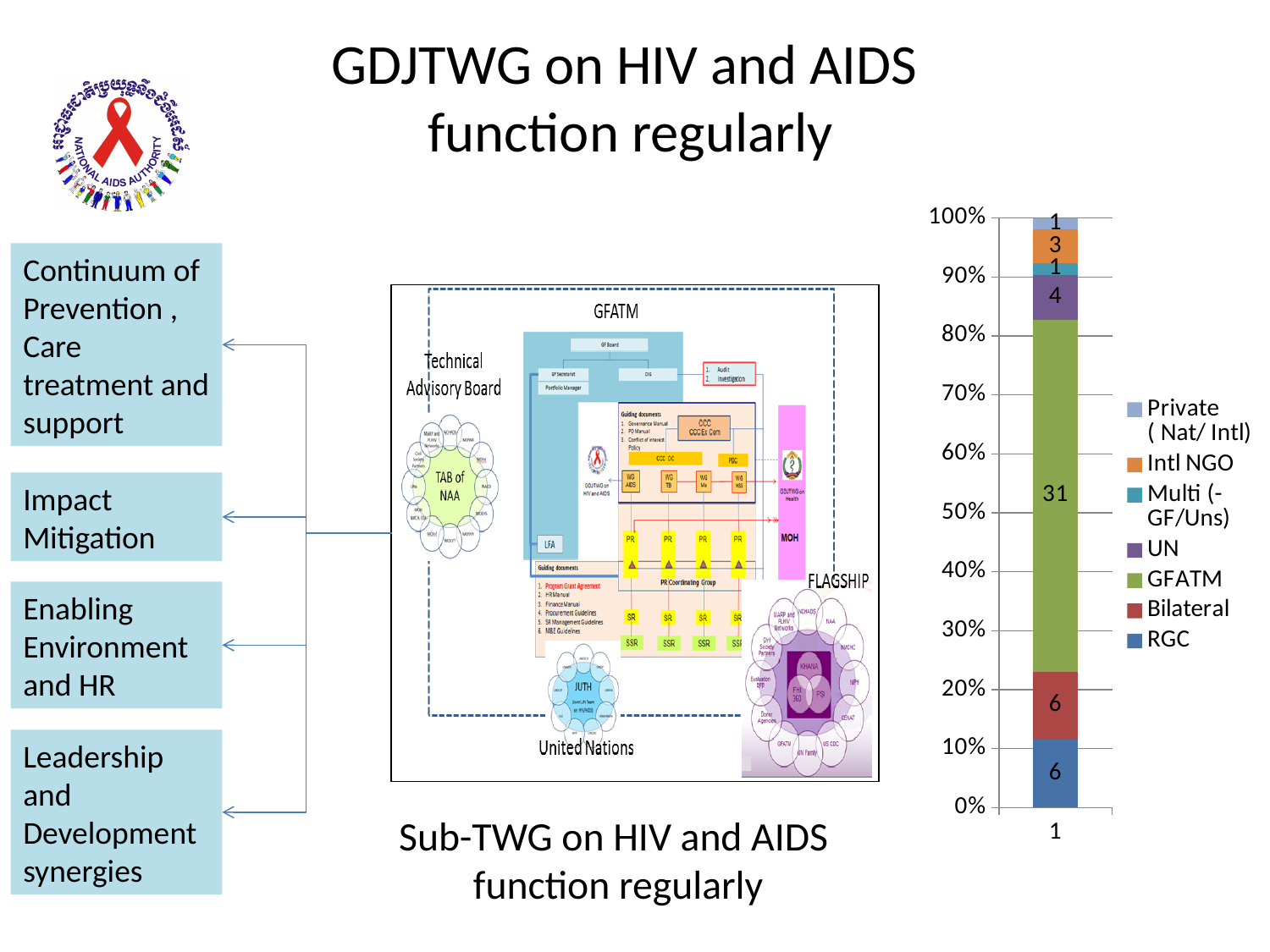
Which series has the largest segment in the stacked bar chart? GFATM What is the value of the UN segment in the stacked bar chart? 4 What is the value of the GFATM segment in the stacked bar chart? 31 What is the value of the Intl NGO segment in the stacked bar chart? 3 What is the difference between the GFATM value and the Bilateral value in the stacked bar chart? 25 Which series is shown in green in the stacked bar chart's legend? GFATM In the stacked bar chart, which is larger: the UN value or the Intl NGO value? UN How many series does the legend of the stacked bar chart list? 7 What is the value of the RGC segment in the stacked bar chart? 6 What kind of chart is shown on the right of the slide? Stacked bar chart What is the value of the Bilateral segment in the stacked bar chart? 6 What is the total of all segments in the stacked bar in the chart? 52